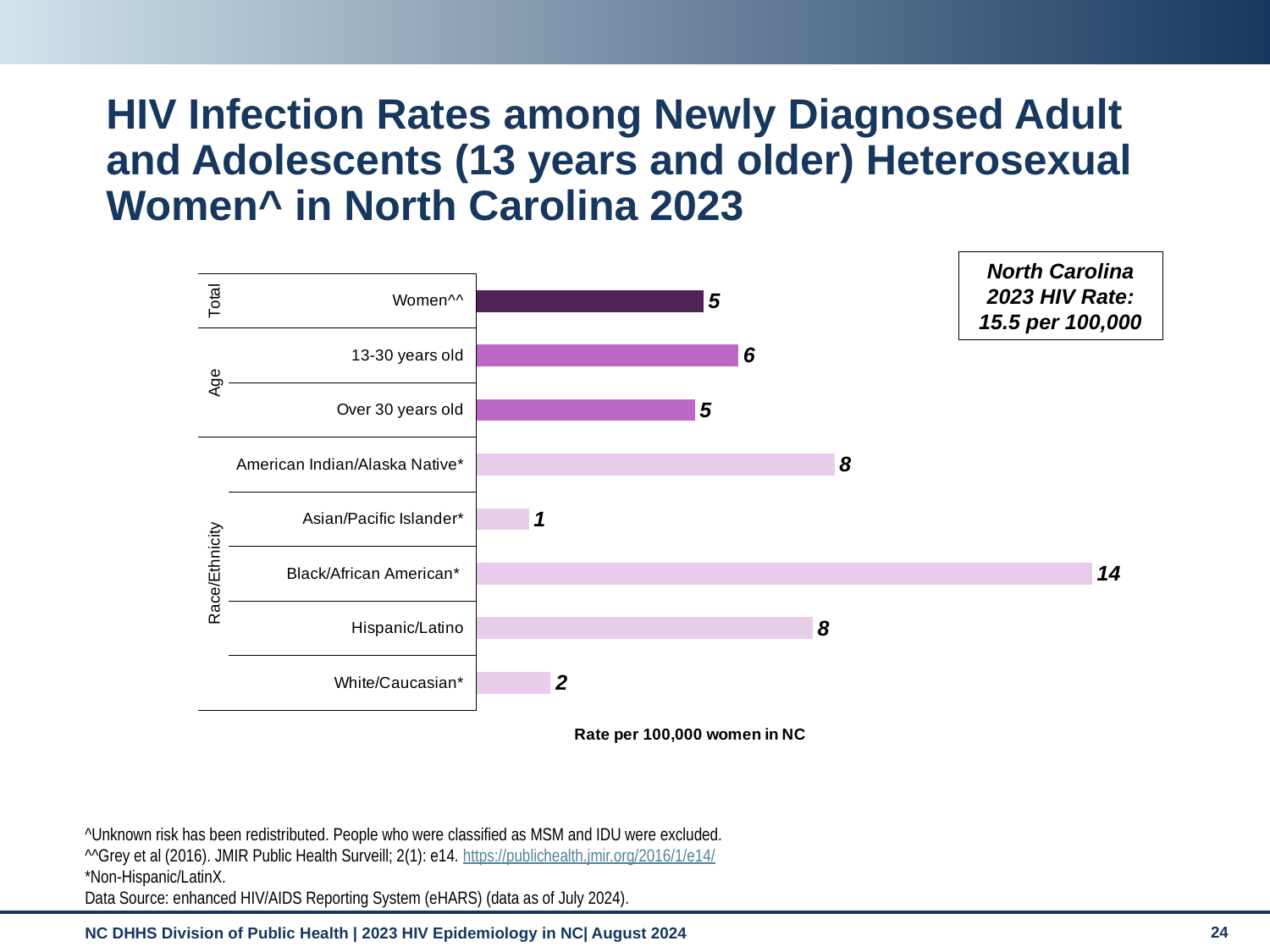
How many categories are plotted in the chart? 8 What is the HIV infection rate for women aged 13-30 years old? 6 Which has a higher HIV infection rate: women 13-30 years old or women over 30 years old? 13-30 years old Which category has the lowest HIV infection rate? Asian/Pacific Islander* What is the HIV infection rate for White/Caucasian* women? 2 What is the difference between the rates for Black/African American* women and Hispanic/Latino women? 6 Which category has the highest HIV infection rate? Black/African American* What is the x-axis label of the chart? Rate per 100,000 women in NC What is the overall North Carolina 2023 HIV rate shown in the text box? 15.5 per 100,000 What kind of chart is shown on the slide? Bar chart What is the HIV infection rate for Asian/Pacific Islander* women? 1 What is the HIV infection rate for Black/African American* women? 14